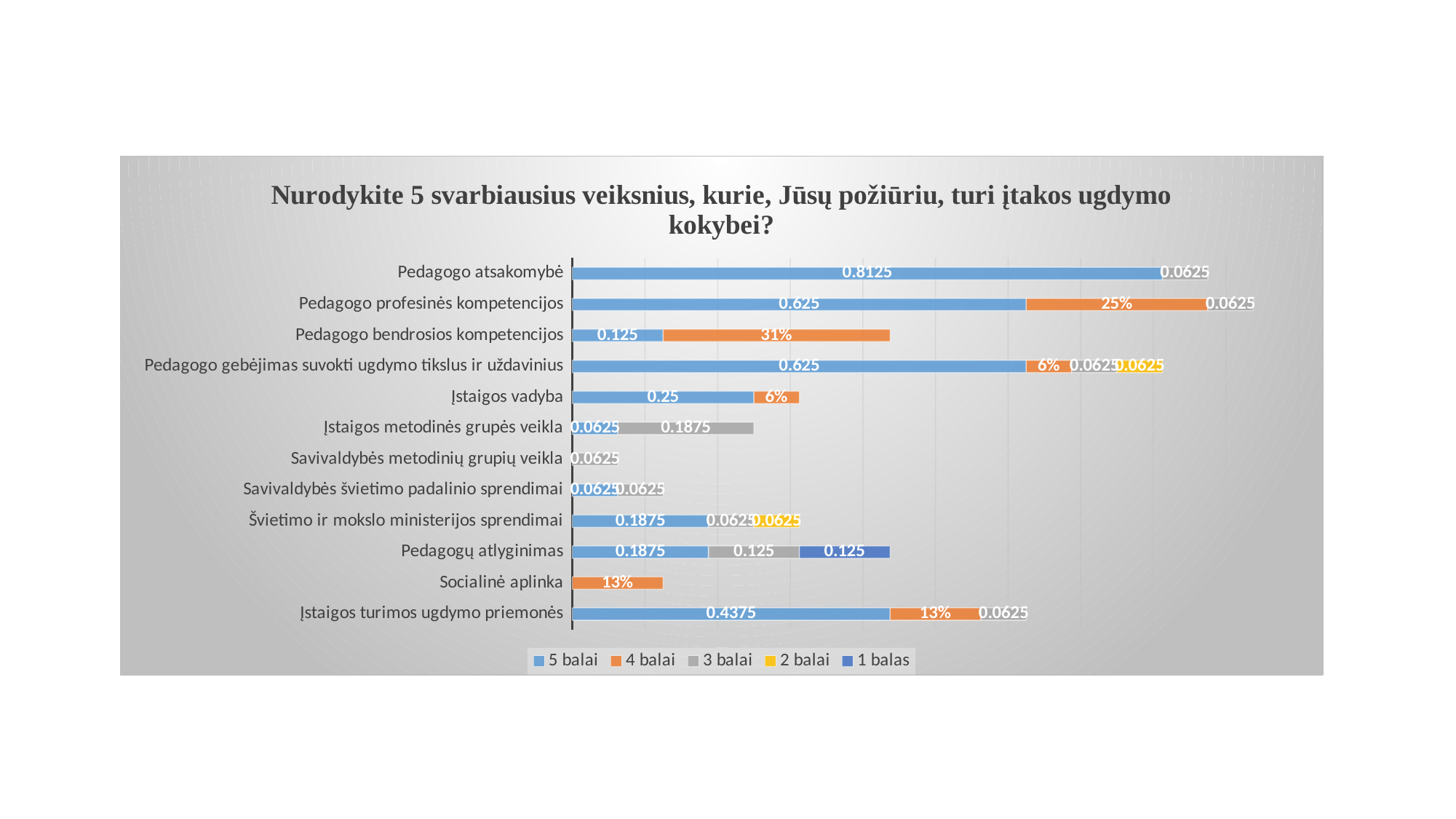
What is the difference between the '5 balai' values for 'Pedagogo atsakomybė' and 'Pedagogo profesinės kompetencijos'? 0.1875 Which series is shown in yellow in the legend? 2 balai What is the total of the stacked bar for 'Pedagogų atlyginimas'? 0.4375 How many categories are shown on the chart? 12 Which has a larger '5 balai' value: 'Įstaigos vadyba' or 'Įstaigos turimos ugdymo priemonės'? Įstaigos turimos ugdymo priemonės How many series does the legend list? 5 What kind of chart is shown on the slide? Stacked bar chart What is the '1 balas' value for 'Pedagogų atlyginimas'? 0.125 What is the '4 balai' value for 'Socialinė aplinka'? 13% Which category has the highest '5 balai' value? Pedagogo atsakomybė What is the '5 balai' value for 'Pedagogo atsakomybė'? 0.8125 What is the '4 balai' value for 'Pedagogo bendrosios kompetencijos'? 31%